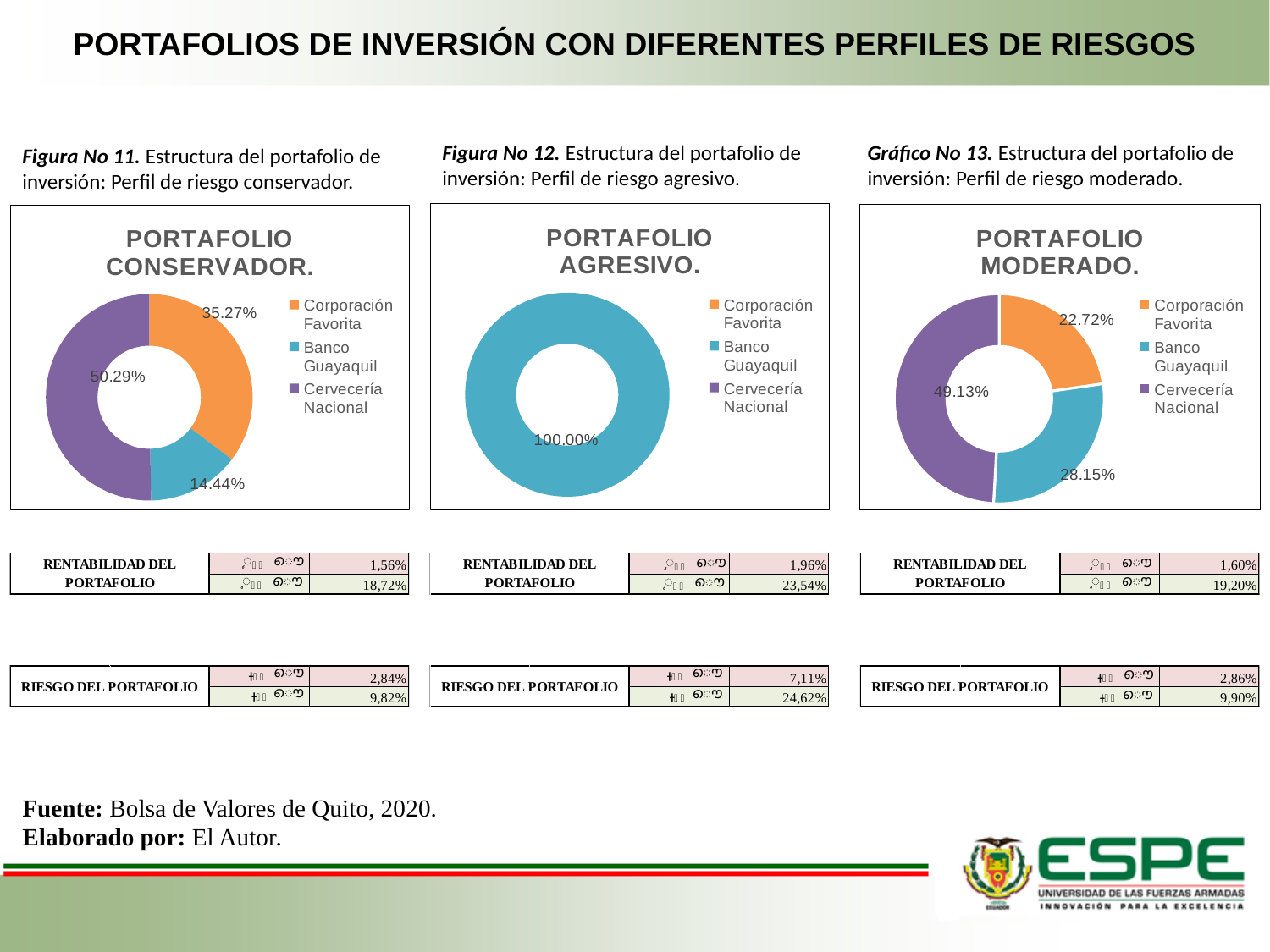
In the PORTAFOLIO CONSERVADOR chart, which holding has the smallest share? Banco Guayaquil In the PORTAFOLIO MODERADO chart, what is the difference between the Cervecería Nacional share and the Banco Guayaquil share? 20.98% In the PORTAFOLIO MODERADO chart, which is larger, the Banco Guayaquil share or the Corporación Favorita share? Banco Guayaquil In the PORTAFOLIO CONSERVADOR chart, what share does Banco Guayaquil hold? 14.44% In the PORTAFOLIO CONSERVADOR chart, which holding has the largest share? Cervecería Nacional What type of chart is the PORTAFOLIO CONSERVADOR chart? Doughnut chart In the PORTAFOLIO MODERADO chart, what share does Cervecería Nacional hold? 49.13% In the PORTAFOLIO MODERADO chart, what share does Corporación Favorita hold? 22.72% In the PORTAFOLIO CONSERVADOR chart, what is the difference between the Corporación Favorita share and the Banco Guayaquil share? 20.83% In the PORTAFOLIO AGRESIVO chart, what share does Banco Guayaquil hold? 100.00% In the PORTAFOLIO CONSERVADOR chart, what share does Cervecería Nacional hold? 50.29% In the PORTAFOLIO AGRESIVO chart, how many entries does the legend list? 3